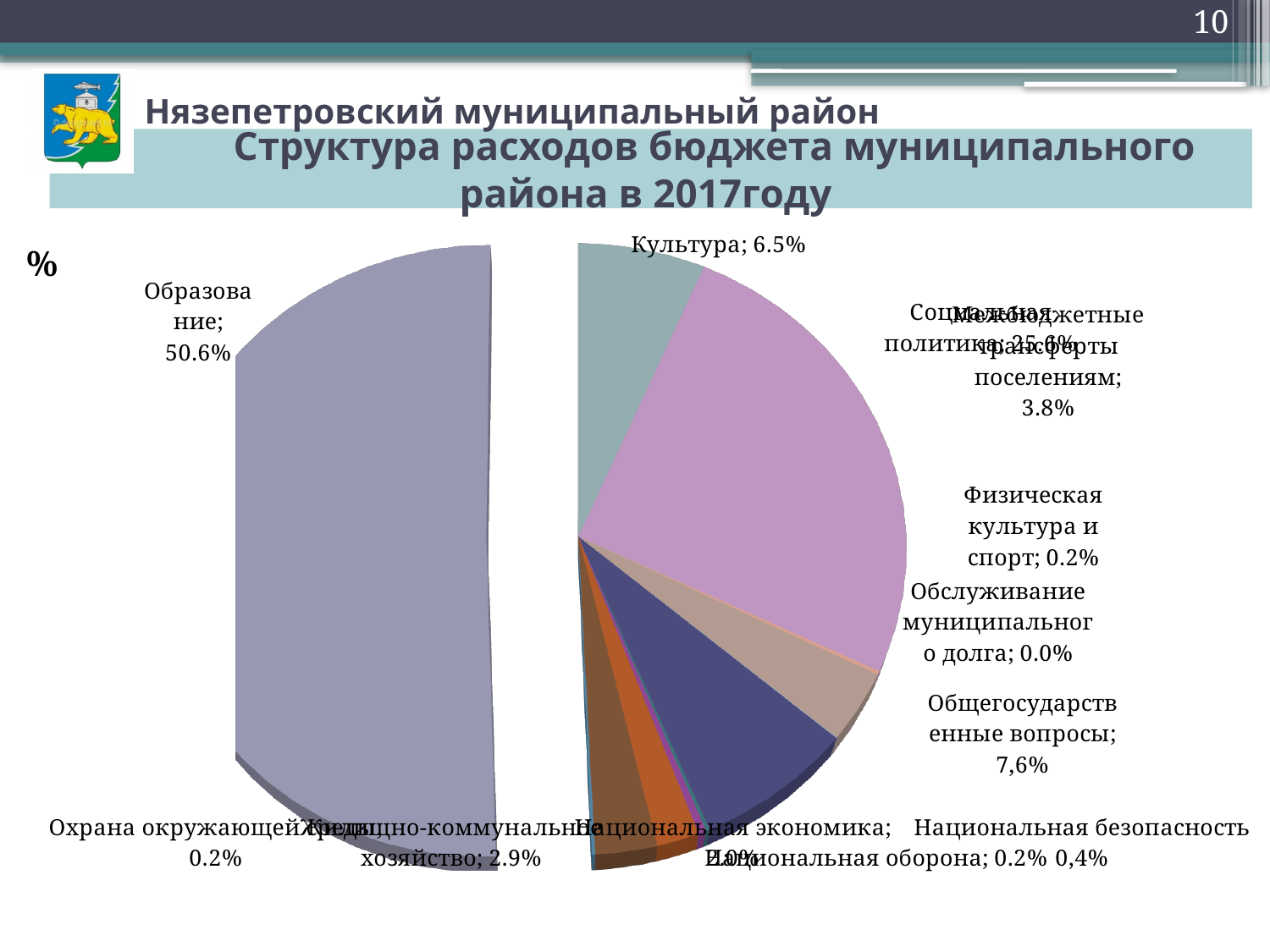
What share is shown for Общегосударственные вопросы? 7,6% What is the difference between the shares of Образование and Культура? 44.1% What share is shown for Обслуживание муниципального долга? 0.0% What share of the budget expenditure goes to Культура? 6.5% What share is shown for Жилищно-коммунальное хозяйство? 2.9% What is the title of the chart? Структура расходов бюджета муниципального района в 2017году What share of the budget expenditure goes to Образование? 50.6% What share is shown for Межбюджетные трансферты поселениям? 3.8% Which expenditure category has the largest share of the pie? Образование Which has a larger share: Культура or Жилищно-коммунальное хозяйство? Культура What type of chart is shown on the slide? Pie chart What share is shown for Физическая культура и спорт? 0.2%